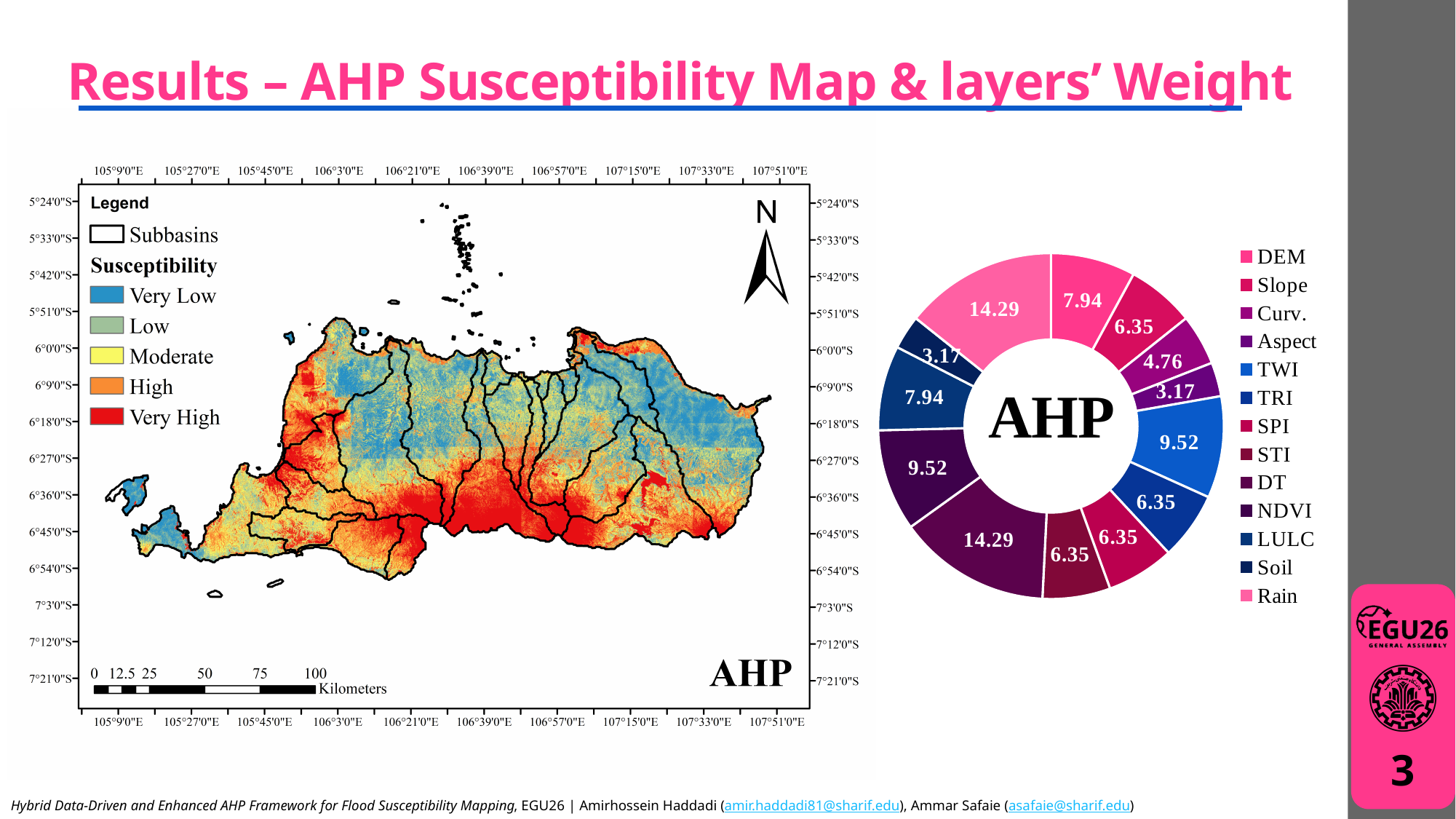
In the doughnut chart, what is the largest value shown on any slice? 14.29 What text is written in the centre of the doughnut chart? AHP In the doughnut chart, what is the difference between the values for Rain and Curv.? 9.53 In the doughnut chart, what is the value for Curv.? 4.76 In the doughnut chart, what is the value for Soil? 3.17 In the doughnut chart, what is the value for DEM? 7.94 How many categories does the legend of the doughnut chart list? 13 In the doughnut chart, what is the smallest value shown on any slice? 3.17 In the doughnut chart, what is the value for TWI? 9.52 What kind of chart is shown on the right side of the slide? Doughnut chart In the doughnut chart, what is the value for Rain? 14.29 In the doughnut chart, which has the larger value, TWI or Slope? TWI